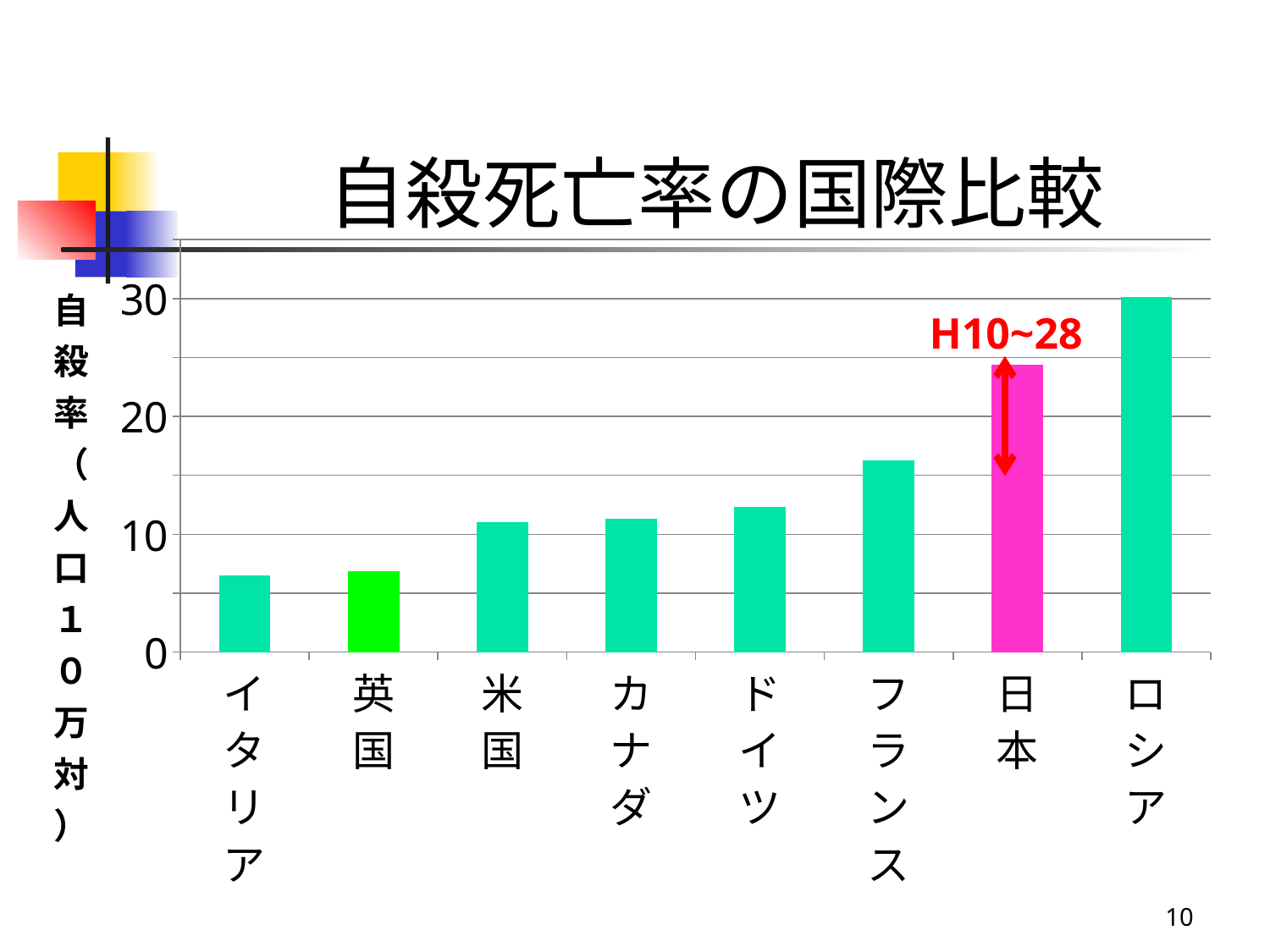
Do the values rise or fall from left to right along the x axis? rise Which country has the highest suicide rate in the chart? ロシア What red annotation is written above the 日本 bar? H10~28 Is the value for 日本 greater or less than 20? greater Is the value for ドイツ greater or less than 10? greater Is the value for フランス greater or less than 20? less What is the title of the chart? 自殺死亡率の国際比較 How many countries are shown on the x axis of the chart? 8 Which has the larger value, 日本 or フランス? 日本 What kind of chart is shown on the slide? bar chart